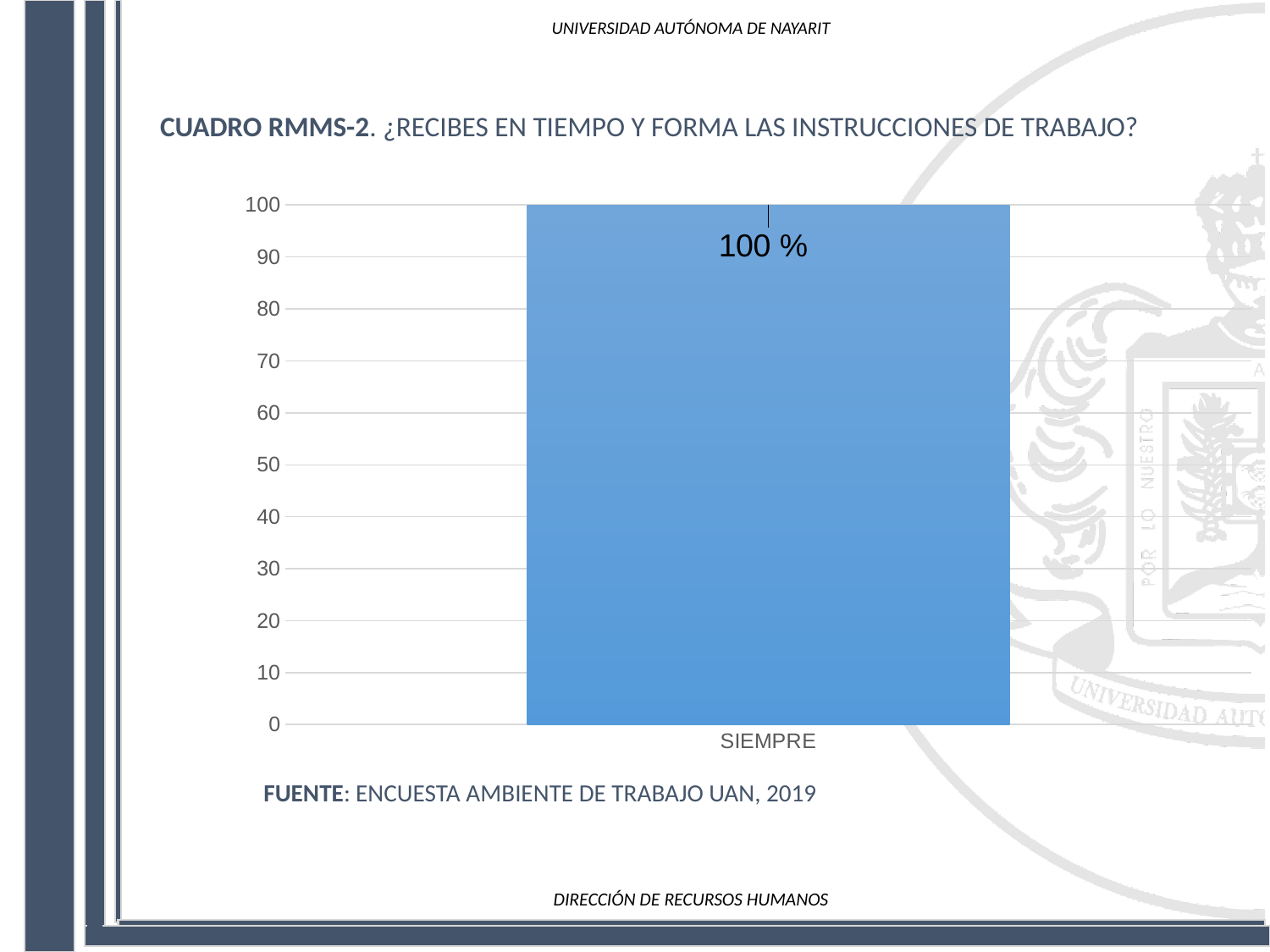
Is the value for SIEMPRE greater or less than 50? greater What kind of chart is shown on the slide? bar chart What is the value shown for SIEMPRE? 100 % How many categories are plotted on the x axis? 1 Is the value for SIEMPRE greater or less than 90? greater What is the label of the only category on the x axis? SIEMPRE What is the maximum value shown on the y axis? 100